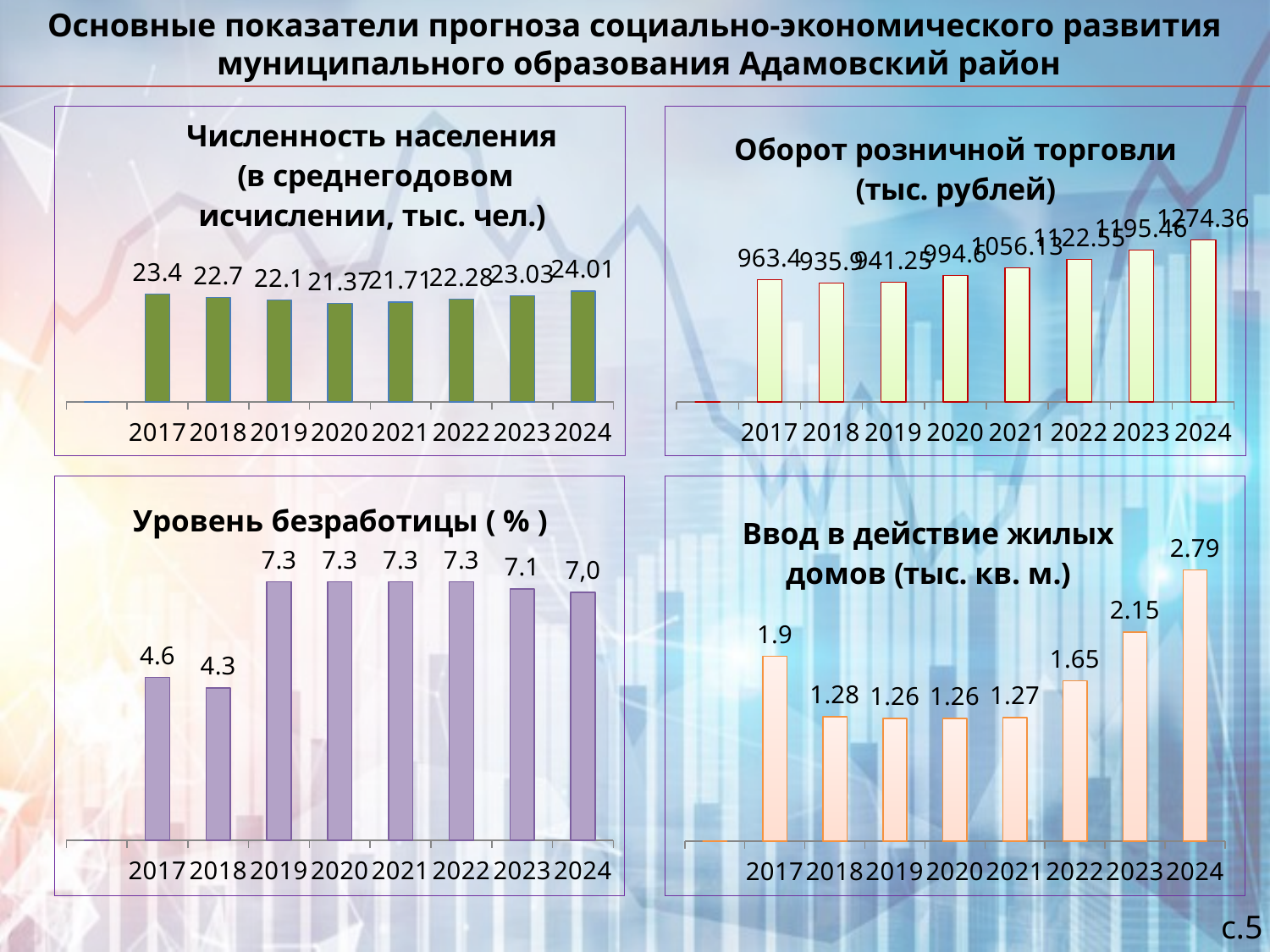
In the chart 'Оборот розничной торговли', is the value for 2018 larger or smaller than the value for 2019? smaller In the chart 'Ввод в действие жилых домов', which year has the highest value? 2024 What type of chart is the bottom-left chart 'Уровень безработицы'? bar chart In the chart 'Ввод в действие жилых домов', what is the value for 2023? 2.15 In the chart 'Уровень безработицы', how many years are shown on the x axis? 8 In the chart 'Ввод в действие жилых домов', what is the difference between the values for 2024 and 2017? 0.89 In the chart 'Уровень безработицы', what is the difference between the values for 2019 and 2017? 2.7 In the chart 'Численность населения', which year has the lowest value? 2020 In the chart 'Уровень безработицы', what is the value for 2018? 4.3 In the chart 'Оборот розничной торговли', which year has the highest value? 2024 In the chart 'Численность населения', what is the value for 2024? 24.01 In the chart 'Оборот розничной торговли', what is the value for 2017? 963.4